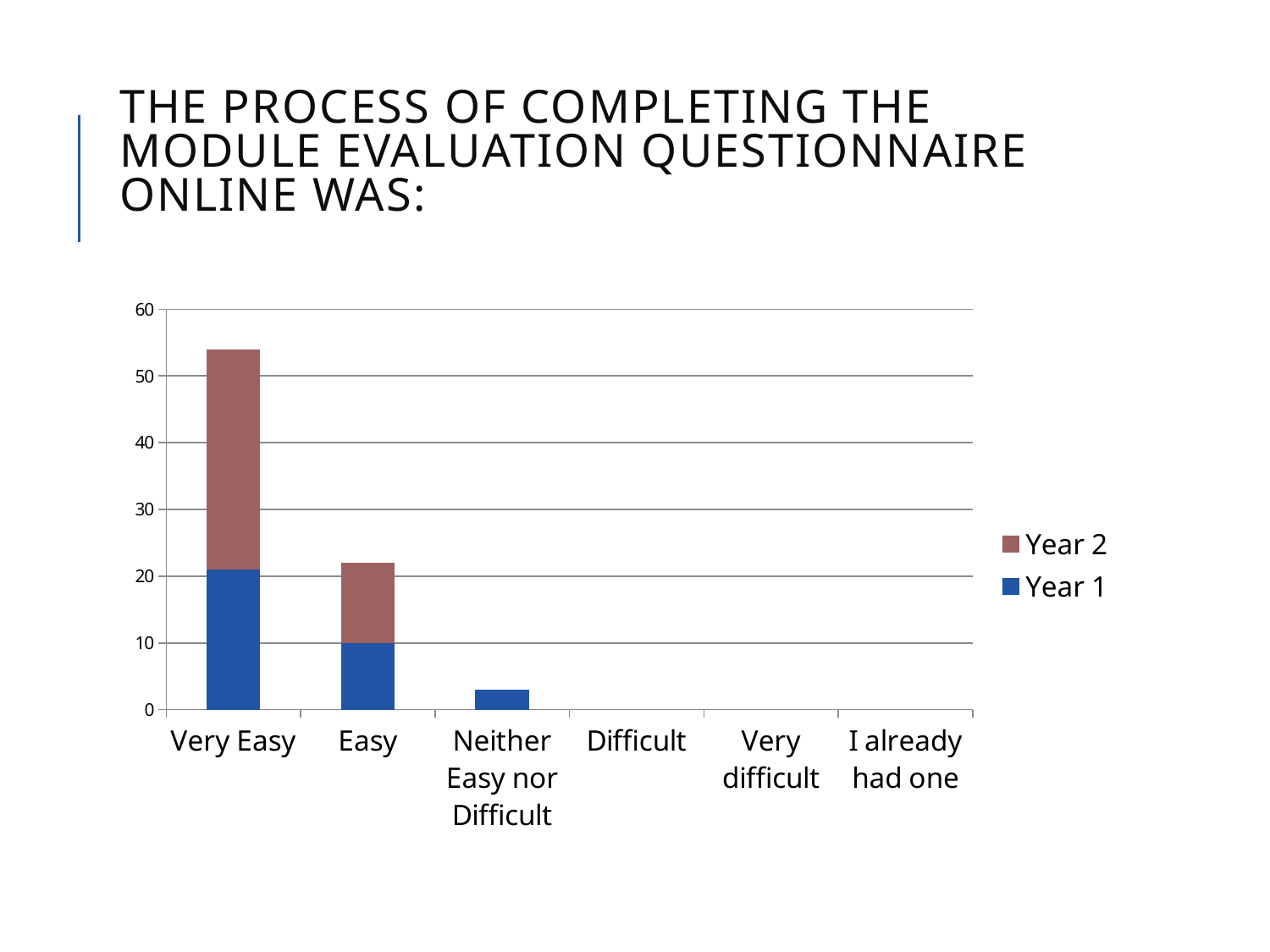
Is the total stacked value for Easy greater or less than 20? greater Is the value for Neither Easy nor Difficult greater or less than 10? less Which series is shown in brown in the legend? Year 2 What kind of chart is shown on the slide? Stacked bar chart Which is larger, the total stacked bar for Very Easy or for Easy? Very Easy How many series does the legend list? 2 Which series is shown in blue in the legend? Year 1 Do the stacked bar totals rise or fall moving from Very Easy to Neither Easy nor Difficult along the x axis? fall How many categories are shown on the x axis? 6 Is the total stacked value for Very Easy greater or less than 50? greater Which category has the tallest stacked bar? Very Easy